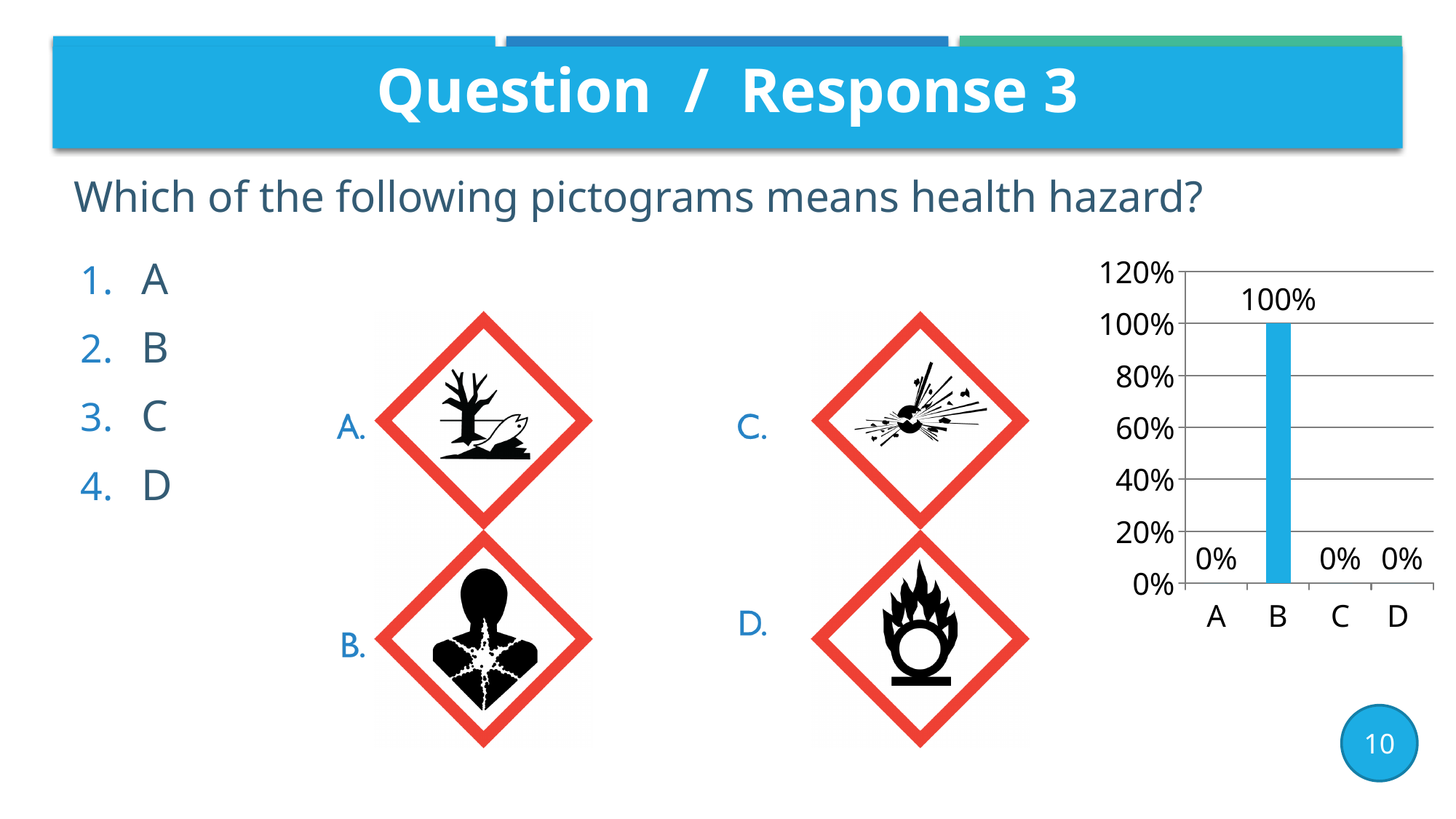
Which is larger in the bar chart, the value for B or the value for C? B What is the value for A in the bar chart? 0% What is the difference between the values for B and A in the bar chart? 100% What is the highest value shown on the y axis of the bar chart? 120% How many categories are shown on the x axis of the bar chart? 4 What is the value for B in the bar chart? 100% What kind of chart is shown on the slide? bar chart What is the value for D in the bar chart? 0% What colour is the bar for B in the bar chart? blue Is the value for B in the bar chart greater or less than 80%? greater Which category has the highest value in the bar chart? B What is the value for C in the bar chart? 0%